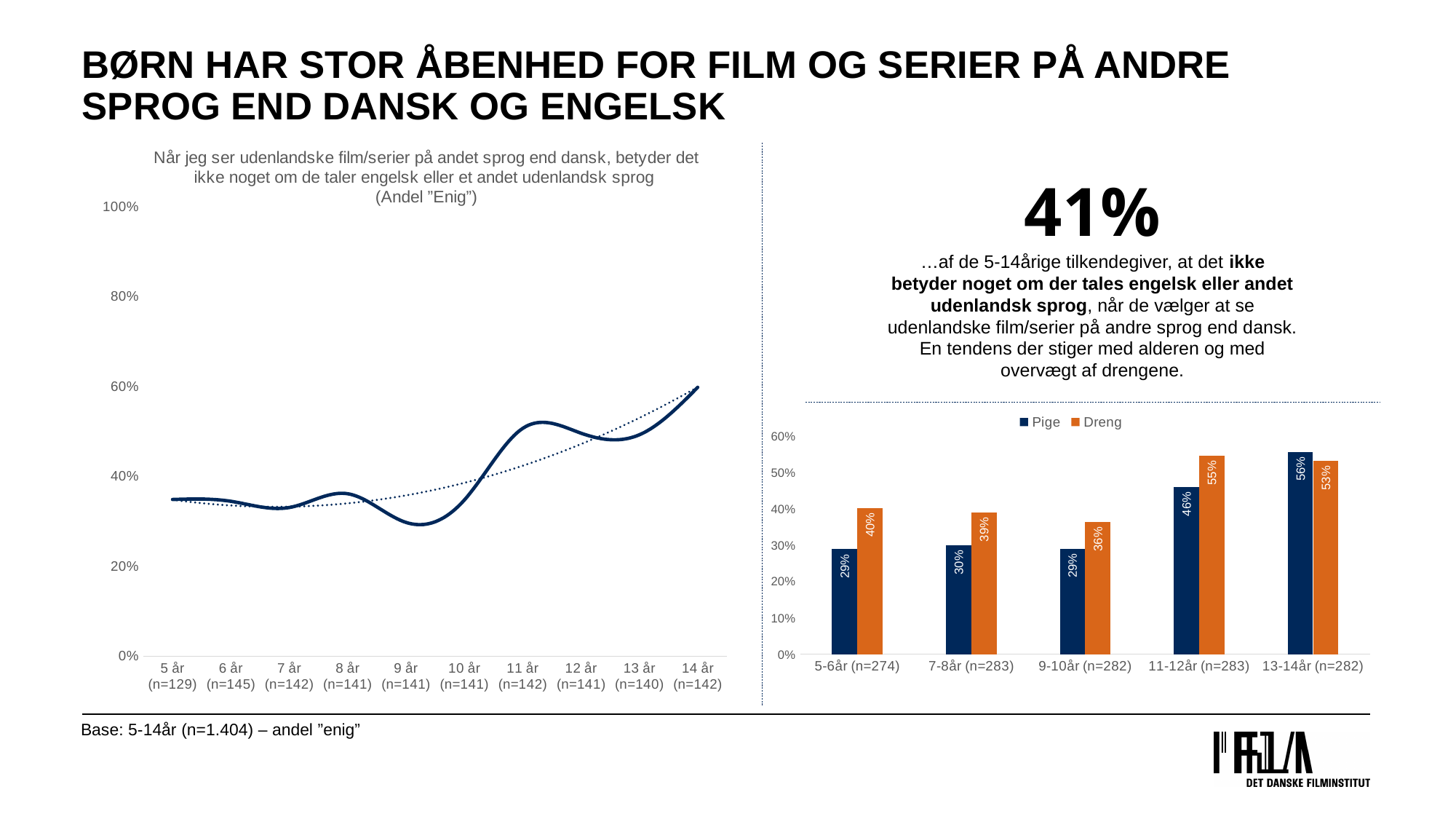
In the chart on the right, what is the difference between Dreng and Pige in the 5-6år (n=274) group? 11% In the chart on the right, how many series does the legend list? 2 What kind of chart is the chart on the right of the slide? bar chart In the chart on the right, which is larger in the 13-14år (n=282) group, Pige or Dreng? Pige What kind of chart is the chart on the left of the slide? line chart In the chart on the left, is the value for 5 år greater or less than 40%? less In the chart on the left, do the values generally rise or fall from 5 år to 14 år? rise In the chart on the right, what is the value for Pige in the 13-14år (n=282) group? 56% In the chart on the left, is the value for 11 år greater or less than 40%? greater In the chart on the right, which age group has the highest value for Pige? 13-14år (n=282) In the chart on the right, what is the value for Dreng in the 11-12år (n=283) group? 55% In the chart on the left, how many age categories are shown on the x axis? 10